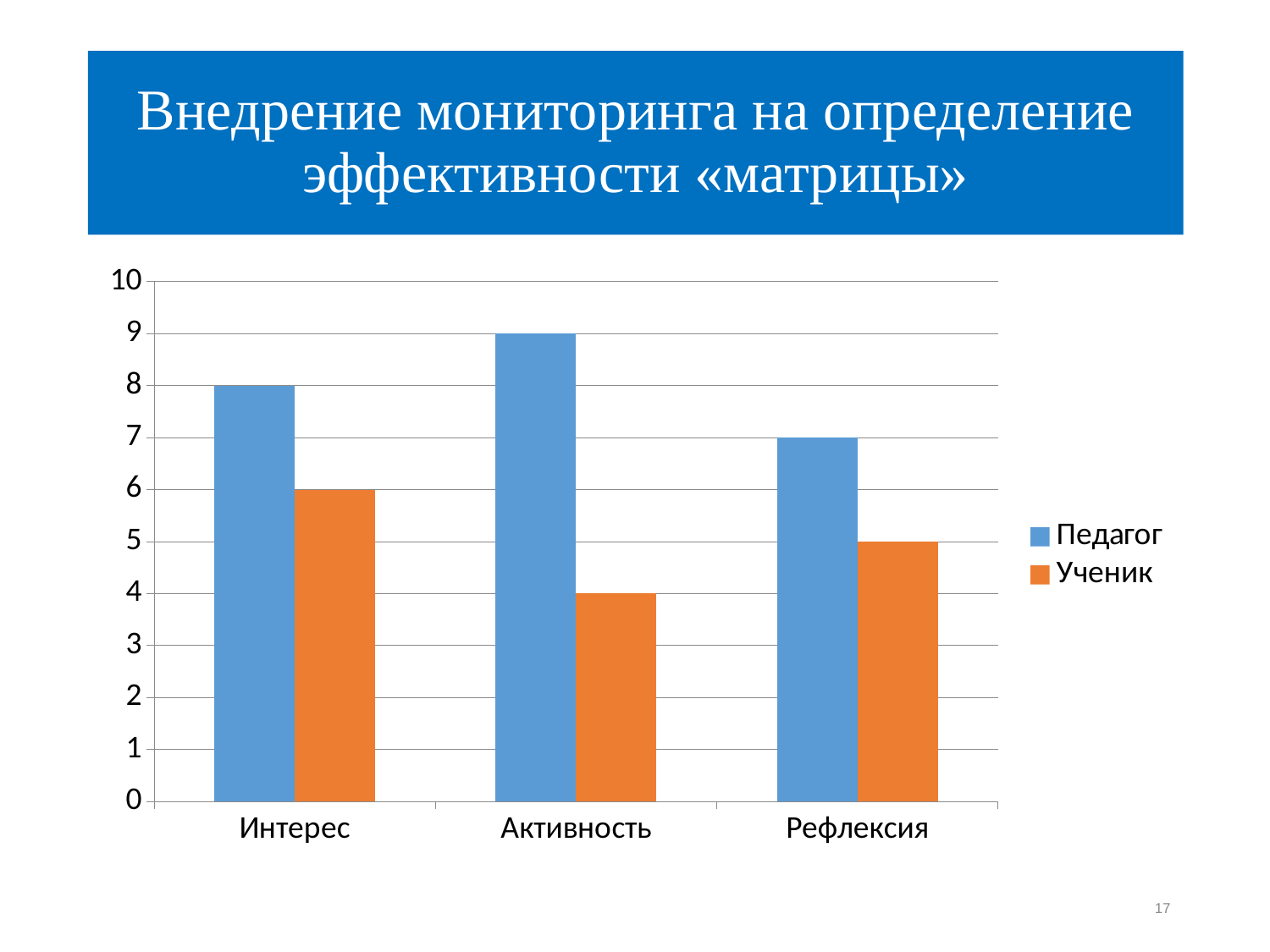
How many series does the legend list? 2 What is the value for Ученик in the Интерес category? 6 Which series is shown in orange? Ученик Which is larger in the Рефлексия category, the Педагог value or the Ученик value? Педагог What is the value for Ученик in the Рефлексия category? 5 In which category is the Ученик value lowest? Активность Is the value for Педагог in the Интерес category greater or less than 5? greater How many categories are shown on the x axis? 3 What is the difference between the Педагог and Ученик values in the Активность category? 5 What is the value for Педагог in the Активность category? 9 What type of chart is shown on the slide? bar chart In which category is the Педагог value highest? Активность